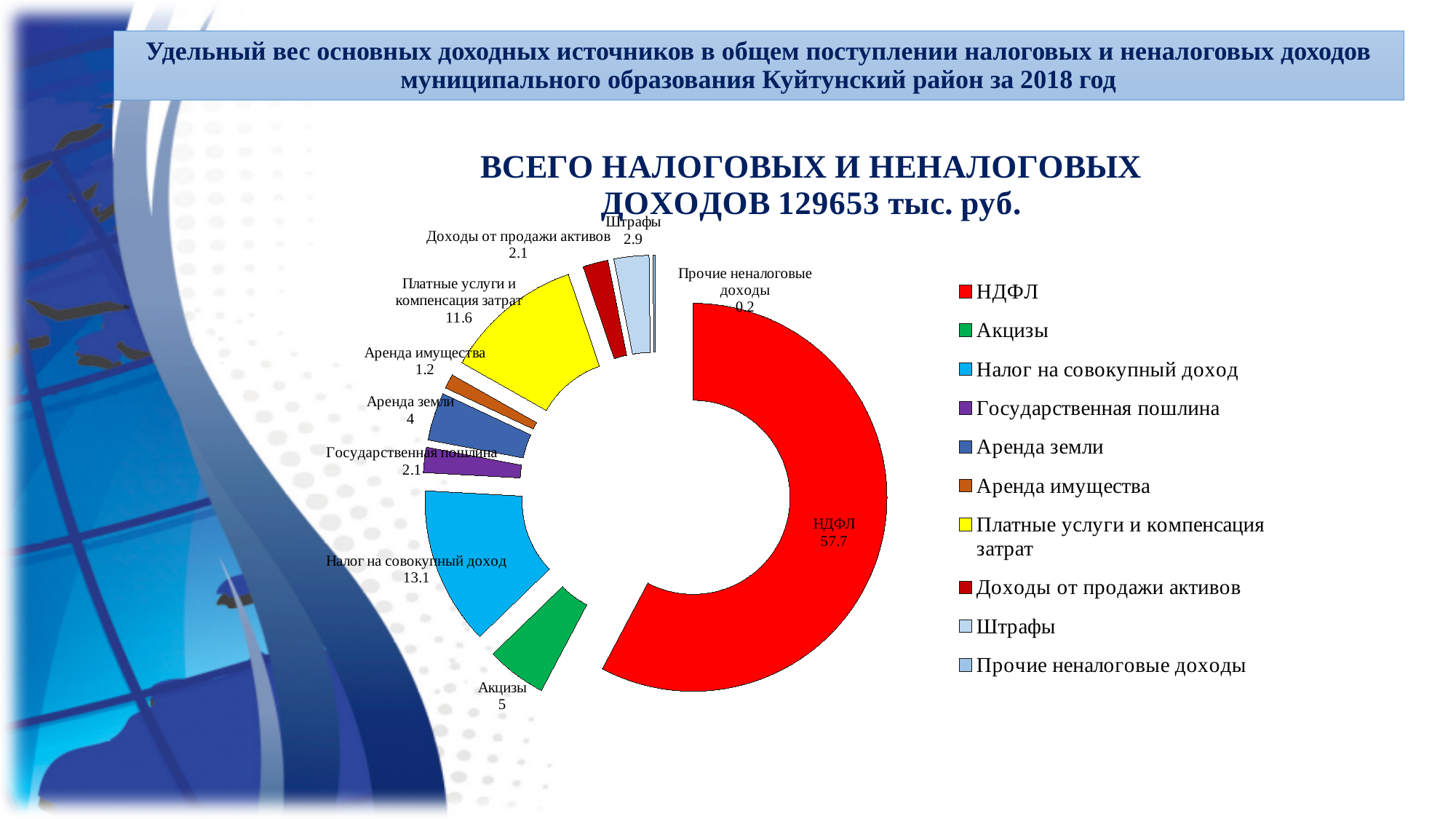
What kind of chart is shown on the slide? Doughnut (pie) chart What is the value shown for Штрафы? 2.9 What total amount of tax and non-tax revenue is stated in the chart title? 129653 тыс. руб. What is the value shown for НДФЛ? 57.7 Which category has the largest share of the chart? НДФЛ Which category has the smallest share of the chart? Прочие неналоговые доходы What is the difference between the values for Налог на совокупный доход and Акцизы? 8.1 Which is larger, the value for Аренда земли or the value for Аренда имущества? Аренда земли What colour is the segment for Акцизы? Green What is the value shown for Платные услуги и компенсация затрат? 11.6 What is the value shown for Налог на совокупный доход? 13.1 How many categories does the legend list? 10